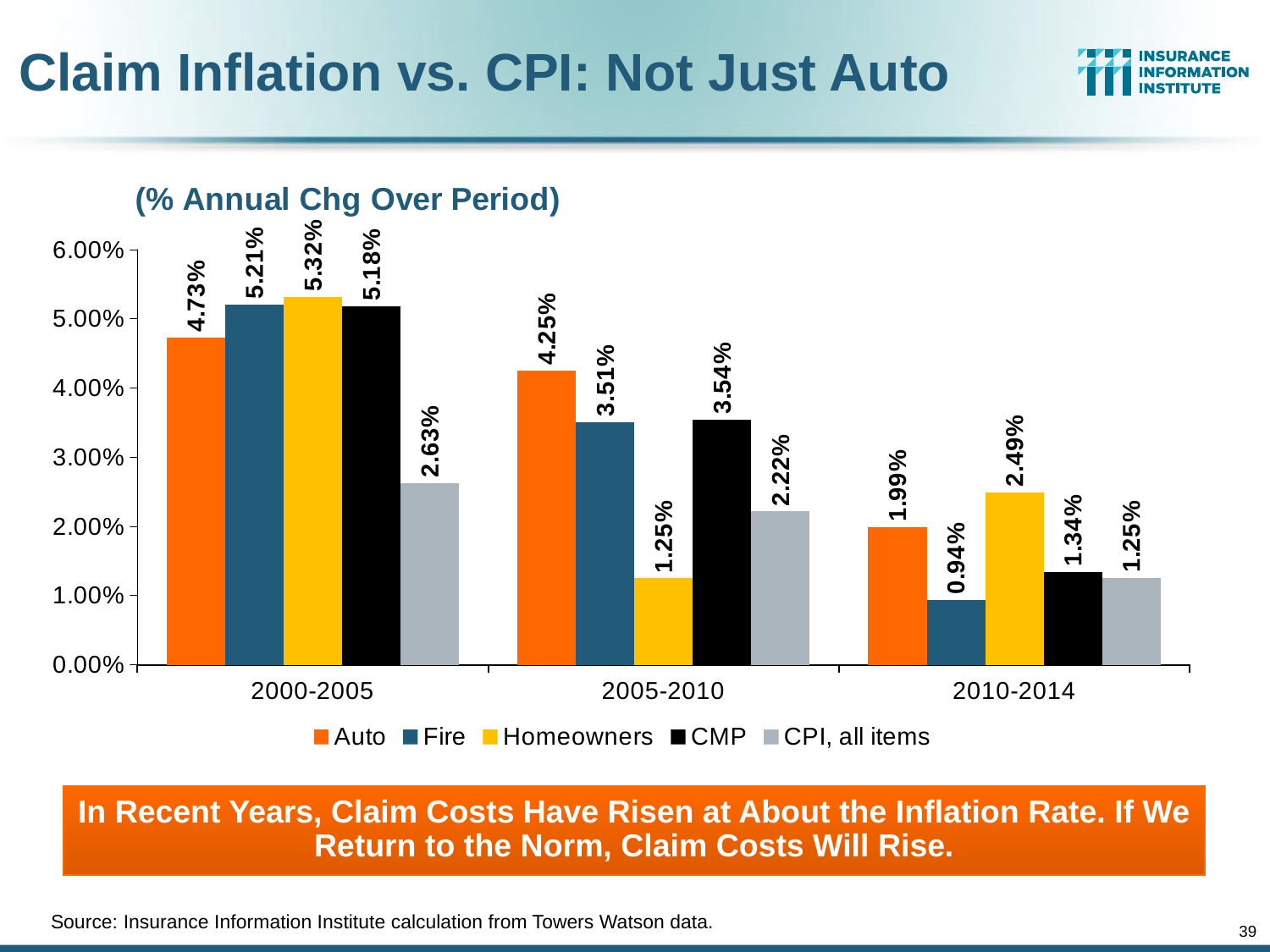
How many periods are shown on the x axis? 3 Which is larger in the 2005-2010 period, Fire or CMP? CMP What kind of chart is shown on the slide? Bar chart Does the Auto value rise or fall across the periods from 2000-2005 to 2010-2014? Fall Which series has the lowest value in the 2010-2014 period? Fire What is the value for CPI, all items in the 2005-2010 period? 2.22% What is the value for Homeowners in the 2010-2014 period? 2.49% Which series has the highest value in the 2000-2005 period? Homeowners What is the value for Auto in the 2000-2005 period? 4.73% What is the difference between the Auto value and the CPI, all items value in the 2005-2010 period? 2.03% How many series does the legend list? 5 Is the value for Homeowners in the 2005-2010 period greater or less than 2.00%? less